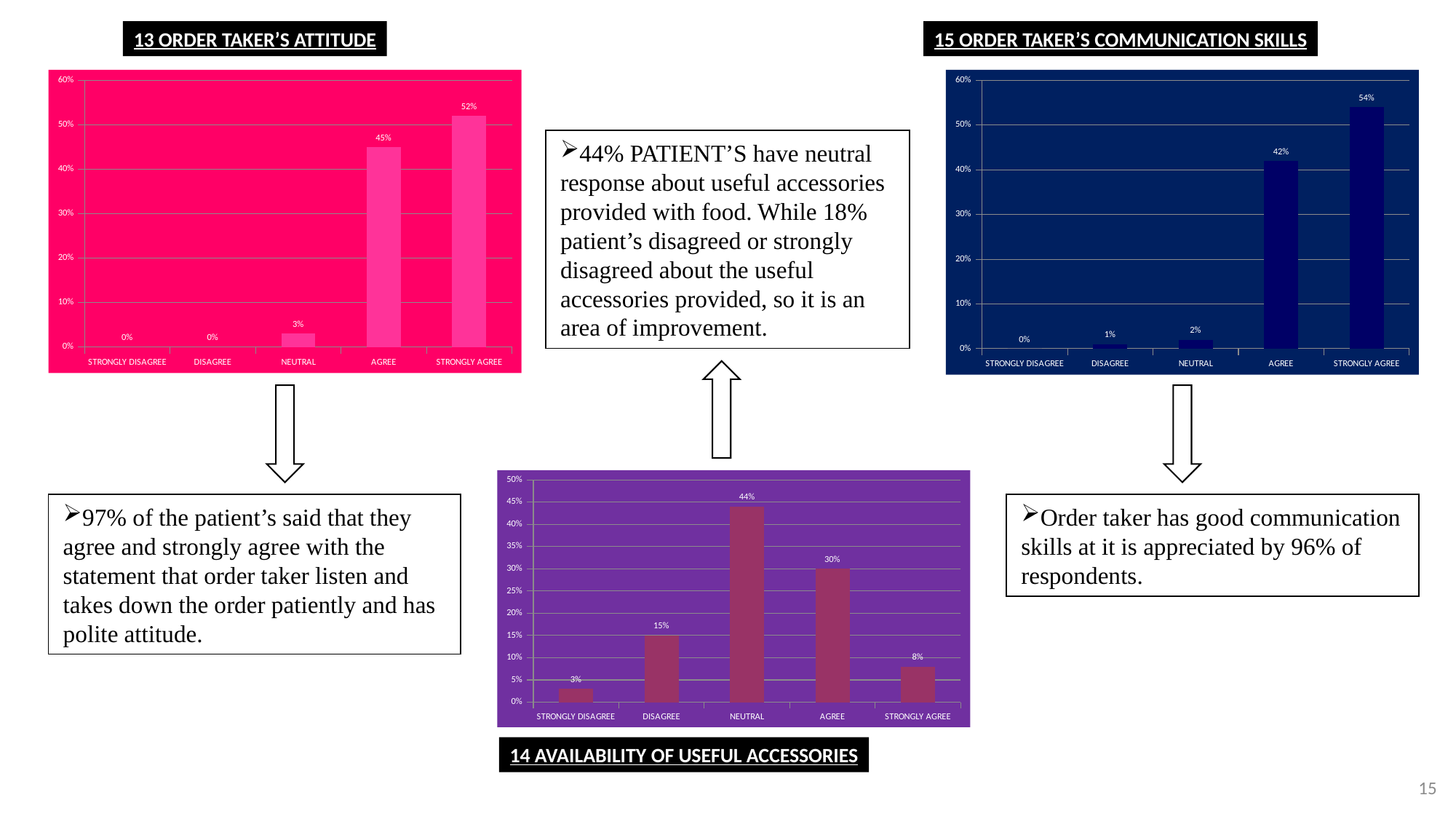
How many categories are shown on the x axis of the '14 Availability of Useful Accessories' chart? 5 In the '13 Order Taker's Attitude' chart, what is the difference between Strongly Agree and Agree? 7% In the '15 Order Taker's Communication Skills' chart, which is larger, Disagree or Neutral? Neutral What type of chart is the '15 Order Taker's Communication Skills' chart? Bar chart In the '15 Order Taker's Communication Skills' chart, what is the value for Neutral? 2% In the '14 Availability of Useful Accessories' chart, what is the difference between Agree and Disagree? 15% In the '13 Order Taker's Attitude' chart, what is the value for Strongly Agree? 52% In the '13 Order Taker's Attitude' chart, what is the value for Neutral? 3% In the '14 Availability of Useful Accessories' chart, which category has the highest value? Neutral In the '15 Order Taker's Communication Skills' chart, what is the value for Agree? 42% In the '13 Order Taker's Attitude' chart, which category has the highest value? Strongly Agree In the '14 Availability of Useful Accessories' chart, what is the value for Neutral? 44%